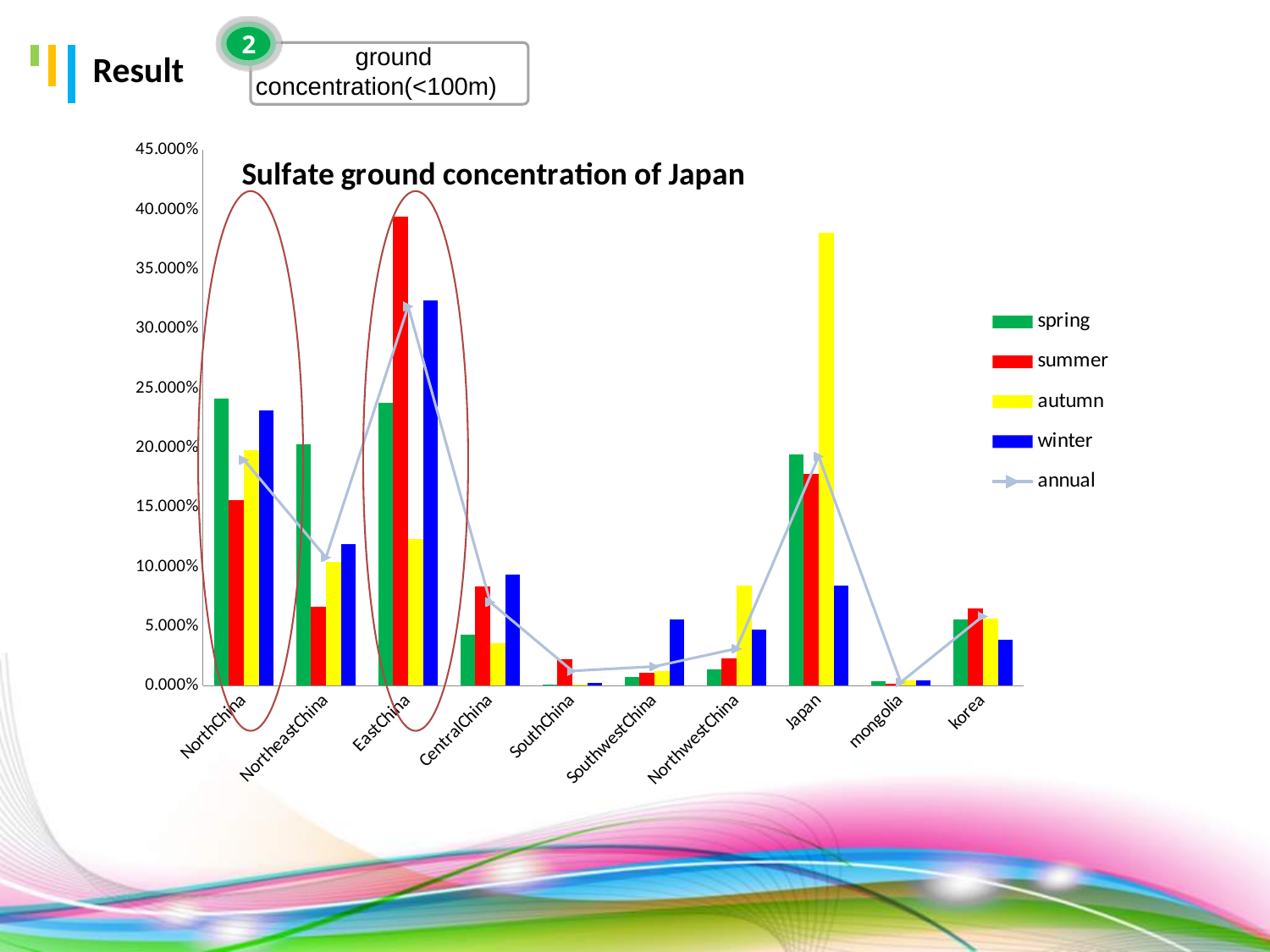
Which is larger, the winter value for NorthChina or the winter value for NortheastChina? NorthChina How many series does the legend list? 5 Is the winter value for EastChina greater or less than 30.000%? greater How many categories are shown on the x axis? 10 Which category has the highest summer value? EastChina Which category has the highest winter value? EastChina Which category has the highest autumn value? Japan What is the title of the chart? Sulfate ground concentration of Japan What kind of chart is this? combination bar and line chart Is the spring value for NorthChina greater or less than 20.000%? greater Is the summer value for EastChina greater or less than 35.000%? greater Which is larger, the autumn value for Japan or the autumn value for EastChina? Japan